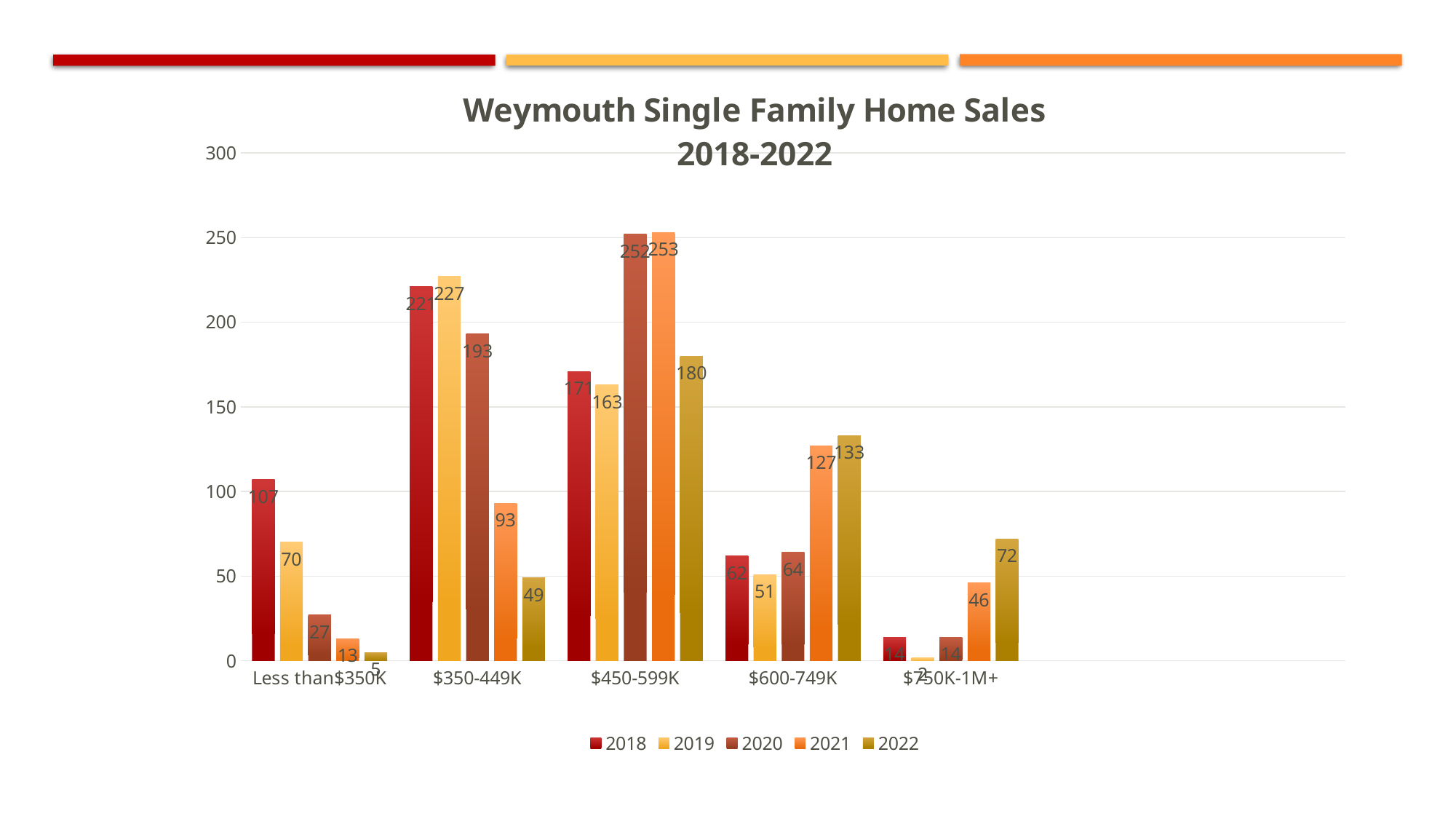
What is the title of the chart? Weymouth Single Family Home Sales 2018-2022 What is the value for 2018 in the Less than $350K category? 107 How many price categories are shown on the x axis? 5 What is the value for 2021 in the $450-599K category? 253 What is the difference between the 2022 and 2018 values in the $600-749K category? 71 Do the 2022 values rise or fall from the Less than $350K category to the $450-599K category? rise Which year has the highest value in the $350-449K category? 2019 Which is larger: the 2020 value for $350-449K or the 2022 value for $450-599K? 2020 value for $350-449K How many series does the legend list? 5 Which year has the lowest value in the $600-749K category? 2019 What is the value for 2022 in the $750K-1M+ category? 72 What type of chart is shown on the slide? bar chart